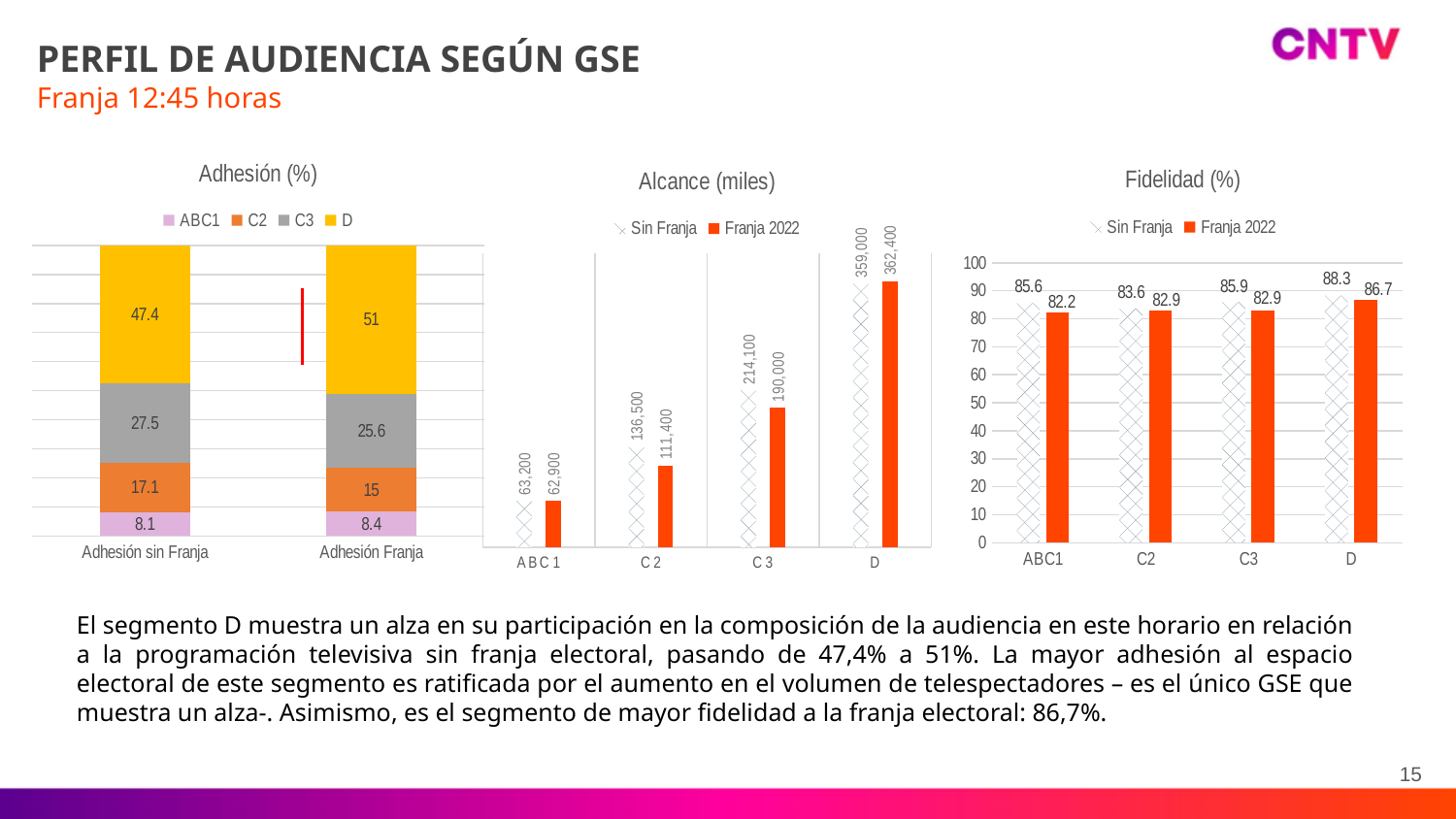
What kind of chart is the Adhesión (%) chart? Stacked bar chart In the Alcance (miles) chart, which category has the highest Franja 2022 value? D In the Adhesión (%) chart, how many series does the legend list? 4 In the Alcance (miles) chart, what is the Franja 2022 value for D? 362,400 In the Alcance (miles) chart, what is the difference between the Sin Franja and Franja 2022 values for C3? 24,100 In the Adhesión (%) chart, what is the value for C3 in the Adhesión sin Franja bar? 27.5 In the Fidelidad (%) chart, what is the Franja 2022 value for D? 86.7 In the Fidelidad (%) chart, which category has the lowest Franja 2022 value? ABC1 In the Alcance (miles) chart, what is the Sin Franja value for C2? 136,500 In the Fidelidad (%) chart, is the Sin Franja value for ABC1 larger or smaller than the Franja 2022 value for ABC1? larger In the Adhesión (%) chart, what is the value for segment D in the Adhesión Franja bar? 51 In the Adhesión (%) chart, what is the total of the Adhesión Franja stacked bar? 100